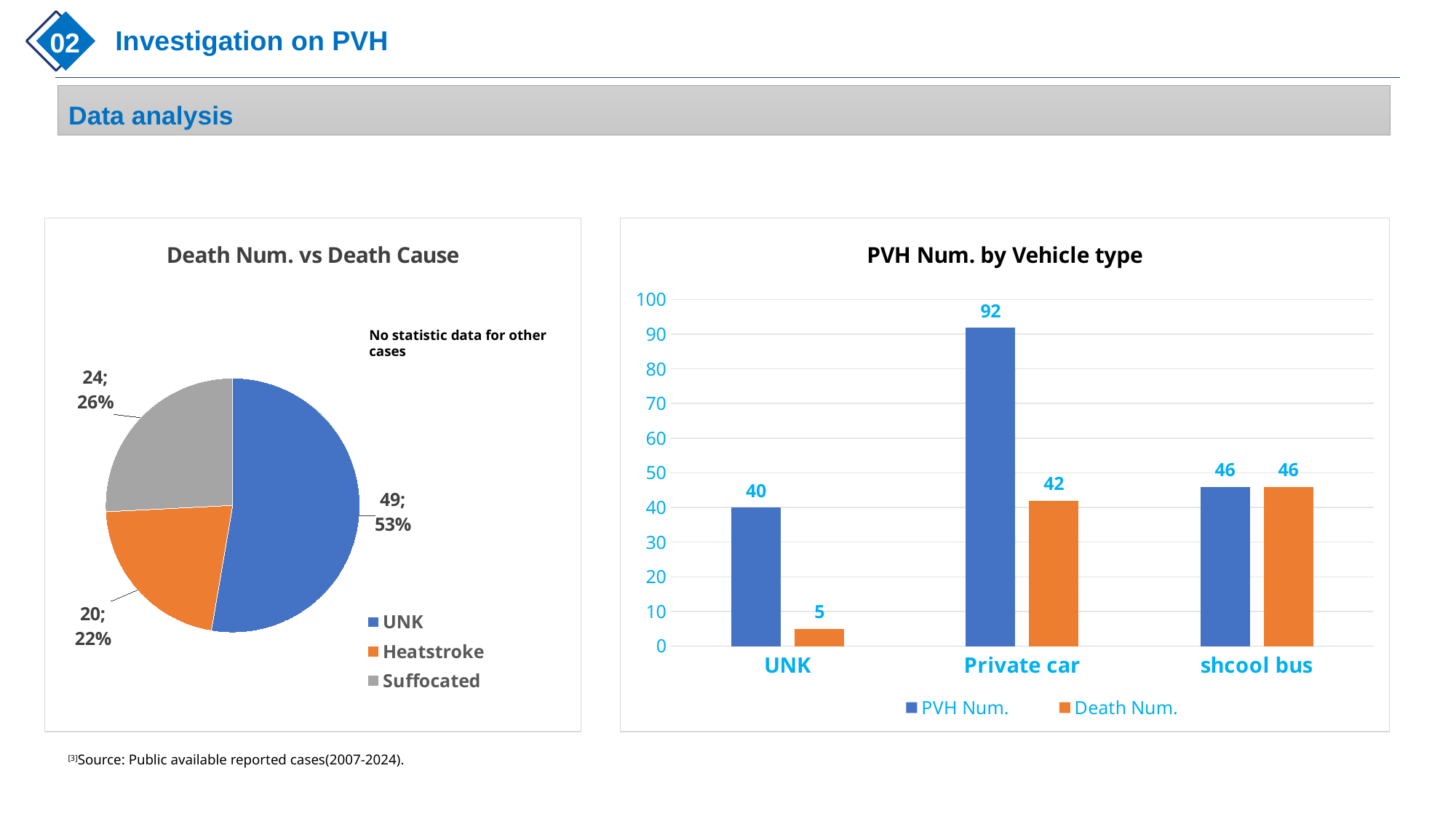
In the 'PVH Num. by Vehicle type' chart, what is the PVH Num. for Private car? 92 In the 'Death Num. vs Death Cause' chart, what kind of chart is shown? pie chart In the 'PVH Num. by Vehicle type' chart, how many series does the legend list? 2 In the 'PVH Num. by Vehicle type' chart, what is the Death Num. for UNK? 5 In the 'PVH Num. by Vehicle type' chart, which is larger: the PVH Num. for UNK or the PVH Num. for shcool bus? shcool bus In the 'PVH Num. by Vehicle type' chart, which vehicle type has the lowest Death Num.? UNK In the 'Death Num. vs Death Cause' chart, how many slices does the pie have? 3 In the 'Death Num. vs Death Cause' chart, what share of the pie is Suffocated? 26% In the 'PVH Num. by Vehicle type' chart, what kind of chart is shown? bar chart In the 'Death Num. vs Death Cause' chart, what is the value for Heatstroke? 20 In the 'Death Num. vs Death Cause' chart, which death cause has the largest slice? UNK In the 'PVH Num. by Vehicle type' chart, what is the difference between PVH Num. and Death Num. for Private car? 50